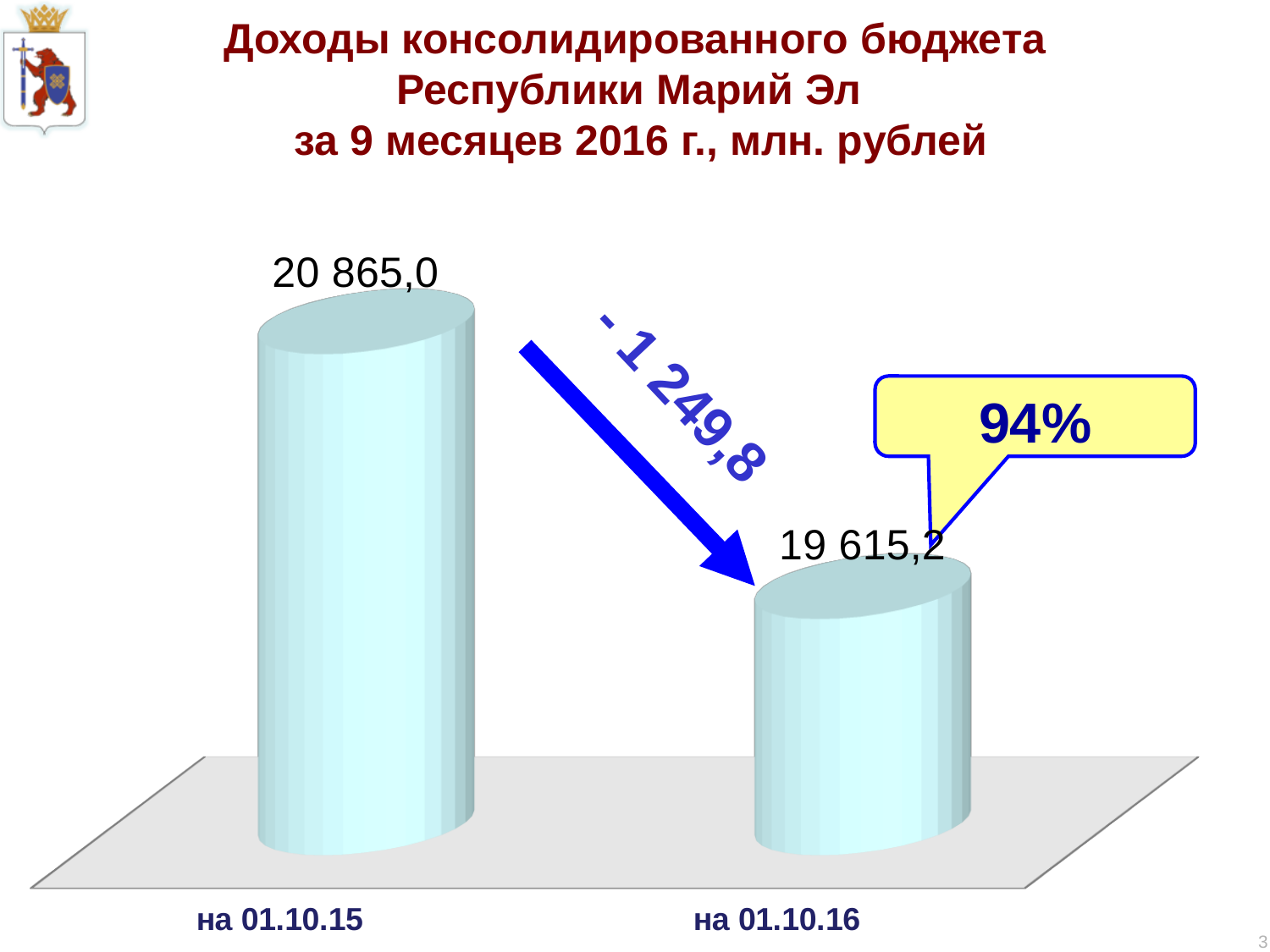
Which category has the lowest value? на 01.10.16 What percentage is shown in the yellow callout next to the на 01.10.16 bar? 94% Do the values rise or fall from на 01.10.15 to на 01.10.16? fall What is the value for на 01.10.15? 20 865,0 What kind of chart is shown on the slide? bar chart What is the difference between the values for на 01.10.15 and на 01.10.16? 1 249,8 Which is larger, the value for на 01.10.15 or the value for на 01.10.16? на 01.10.15 What is the value for на 01.10.16? 19 615,2 Which category has the highest value? на 01.10.15 How many categories are shown in the chart? 2 What change is written along the blue arrow between the two bars? - 1 249,8